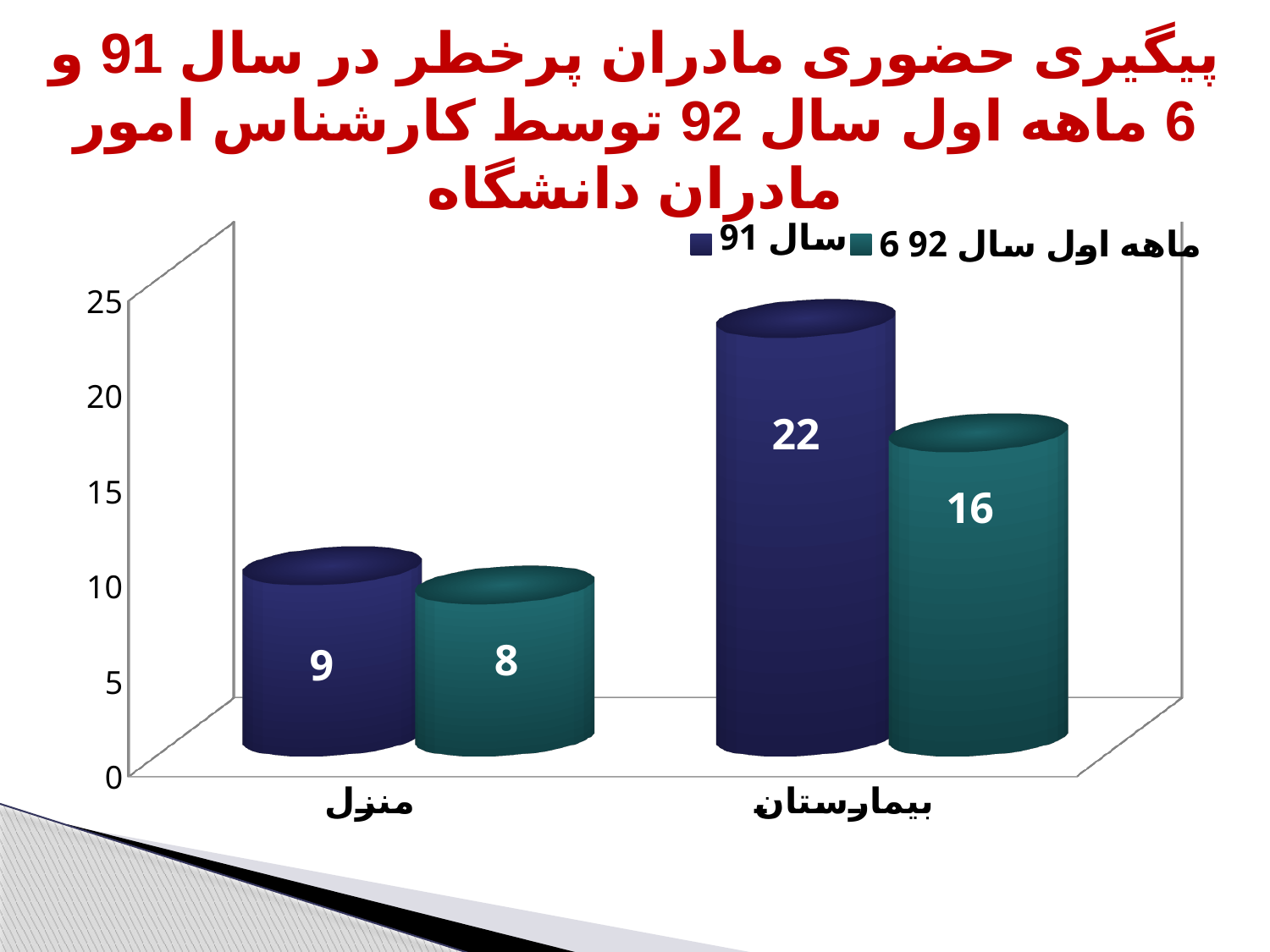
Which category has the highest value in the سال 91 series? بیمارستان What is the value for بیمارستان in the 6 ماهه اول سال 92 series? 16 How many categories are shown on the x axis? 2 What is the value for منزل in the 6 ماهه اول سال 92 series? 8 Which colour represents the سال 91 series in the legend? dark blue Which is larger for منزل: the سال 91 value or the 6 ماهه اول سال 92 value? سال 91 What is the value for منزل in the سال 91 series? 9 What is the difference between the سال 91 and 6 ماهه اول سال 92 values for بیمارستان? 6 How many series does the legend list? 2 What is the value for بیمارستان in the سال 91 series? 22 Which category has the lowest value in the 6 ماهه اول سال 92 series? منزل What kind of chart is shown on the slide? bar chart